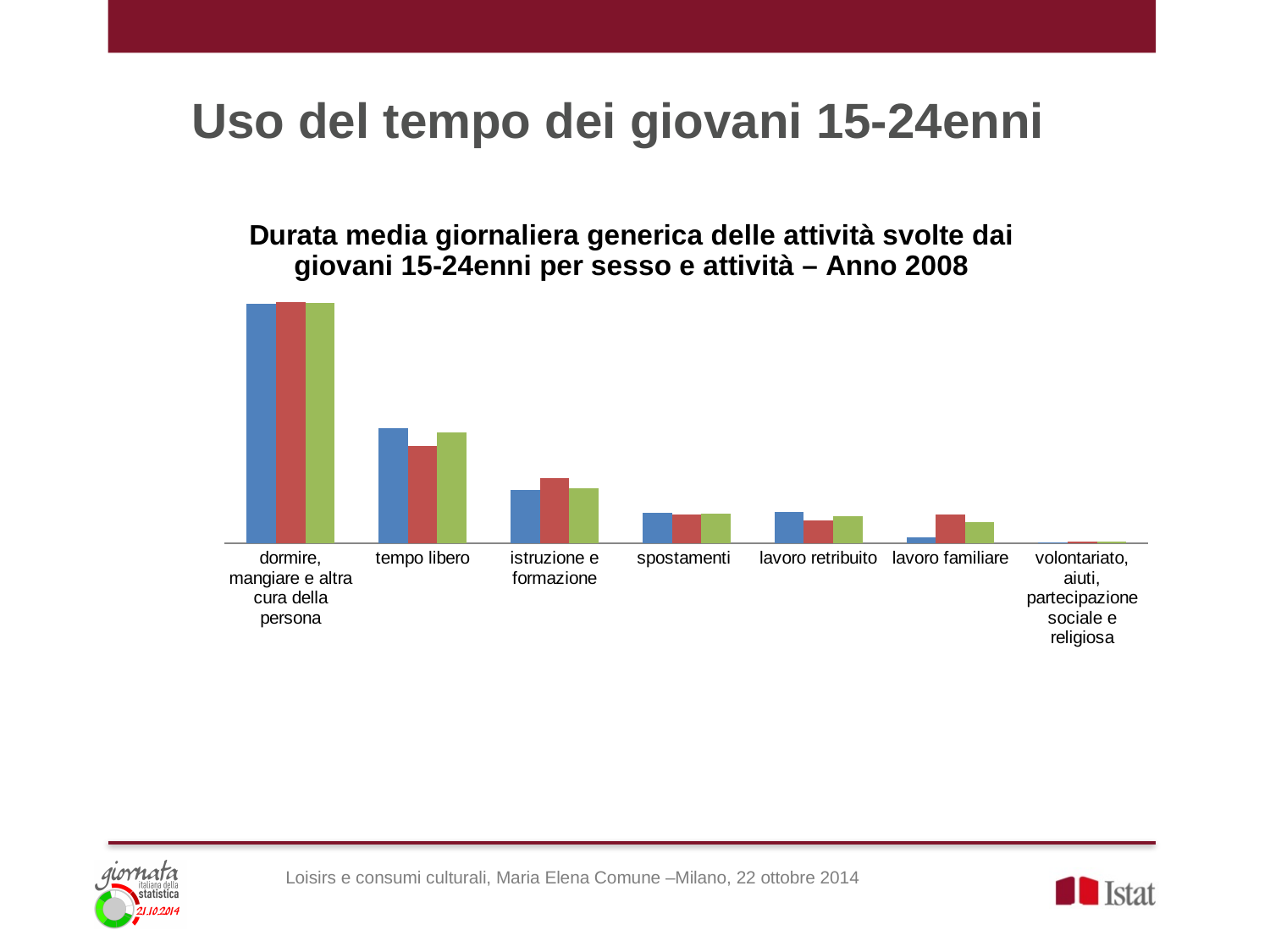
What kind of chart is shown on the slide? bar chart Within the tempo libero category, which bar is taller, the blue one or the red one? the blue one Do the bar heights generally rise or fall moving from left to right along the x axis? fall What year does the chart title say the data refer to? 2008 Which activity category has the highest bars in the chart? dormire, mangiare e altra cura della persona Within the istruzione e formazione category, which coloured bar is the tallest? the red one How many activity categories are shown on the x axis of the chart? 7 Within the lavoro familiare category, which coloured bar is the shortest? the blue one How many bars are plotted for each activity category? 3 Which category has higher bars, tempo libero or istruzione e formazione? tempo libero Which activity category has the lowest bars in the chart? volontariato, aiuti, partecipazione sociale e religiosa Within the lavoro retribuito category, which bar is taller, the blue one or the red one? the blue one